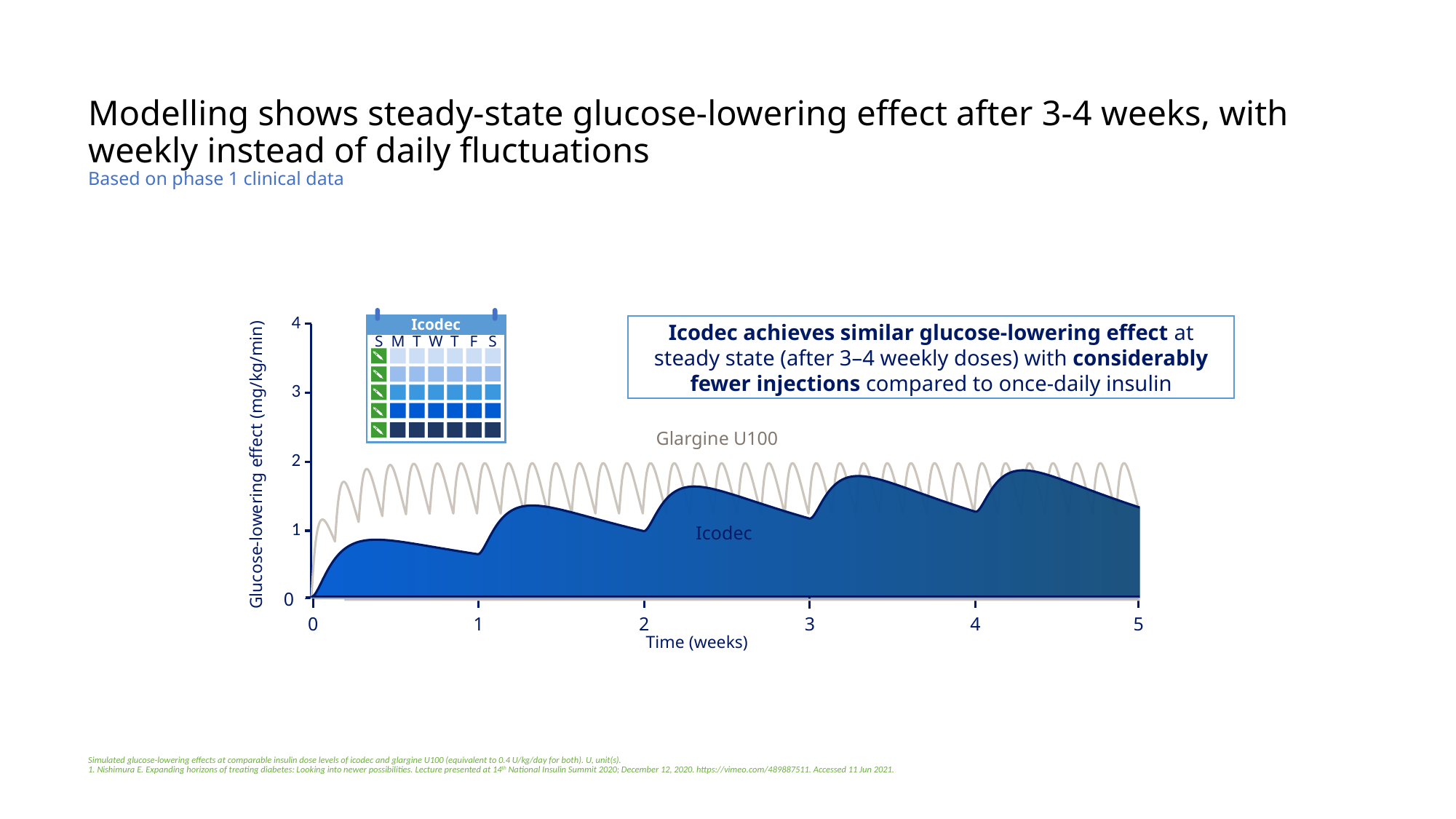
What is the label of the y axis? Glucose-lowering effect (mg/kg/min) Is the Icodec value at week 4 greater or less than 1? greater What is the last value shown on the x axis? 5 What are the names of the two series plotted on the chart? Icodec and Glargine U100 Is the peak Icodec value between week 4 and week 5 greater or less than 2? less What kind of chart is shown on the slide? Line chart How many series are plotted on the chart? 2 Is the Icodec value at week 1 greater or less than 1? less What is the highest value shown on the y axis? 4 Do the weekly peaks of the Icodec series rise or fall from week 1 to week 5? Rise At week 1, which series has the higher value, Icodec or Glargine U100? Glargine U100 What is the label of the x axis? Time (weeks)